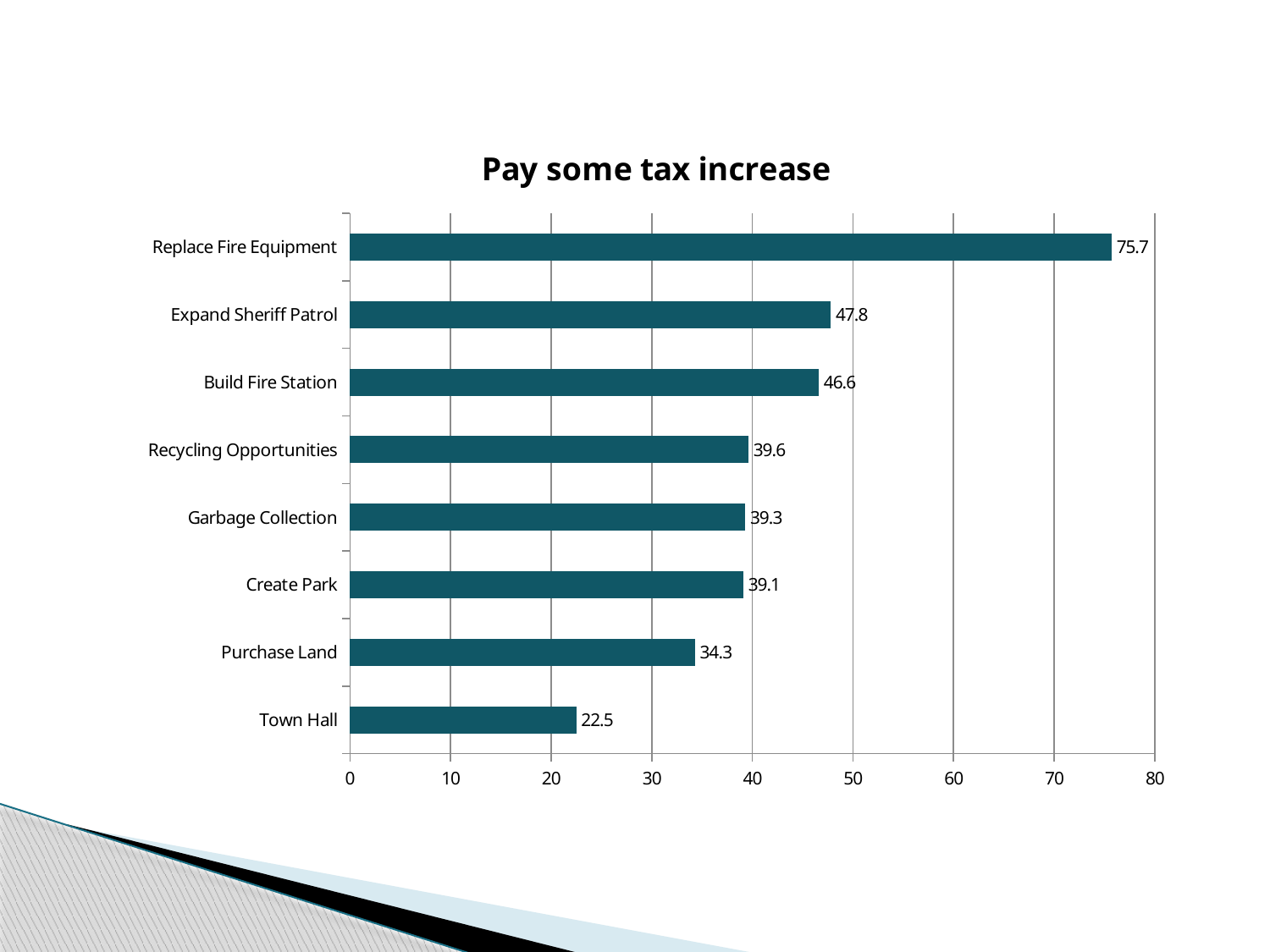
What is the value for Town Hall? 22.5 What is the value for Replace Fire Equipment? 75.7 Which is larger, the value for Build Fire Station or the value for Purchase Land? Build Fire Station What is the value for Recycling Opportunities? 39.6 Which category has the lowest value? Town Hall What is the difference between the values for Replace Fire Equipment and Expand Sheriff Patrol? 27.9 What kind of chart is shown on the slide? Bar chart How many categories are shown in the chart? 8 Is the value for Expand Sheriff Patrol greater or less than 40? greater Which category has the highest value? Replace Fire Equipment What is the title of the chart? Pay some tax increase What is the difference between the values for Purchase Land and Town Hall? 11.8